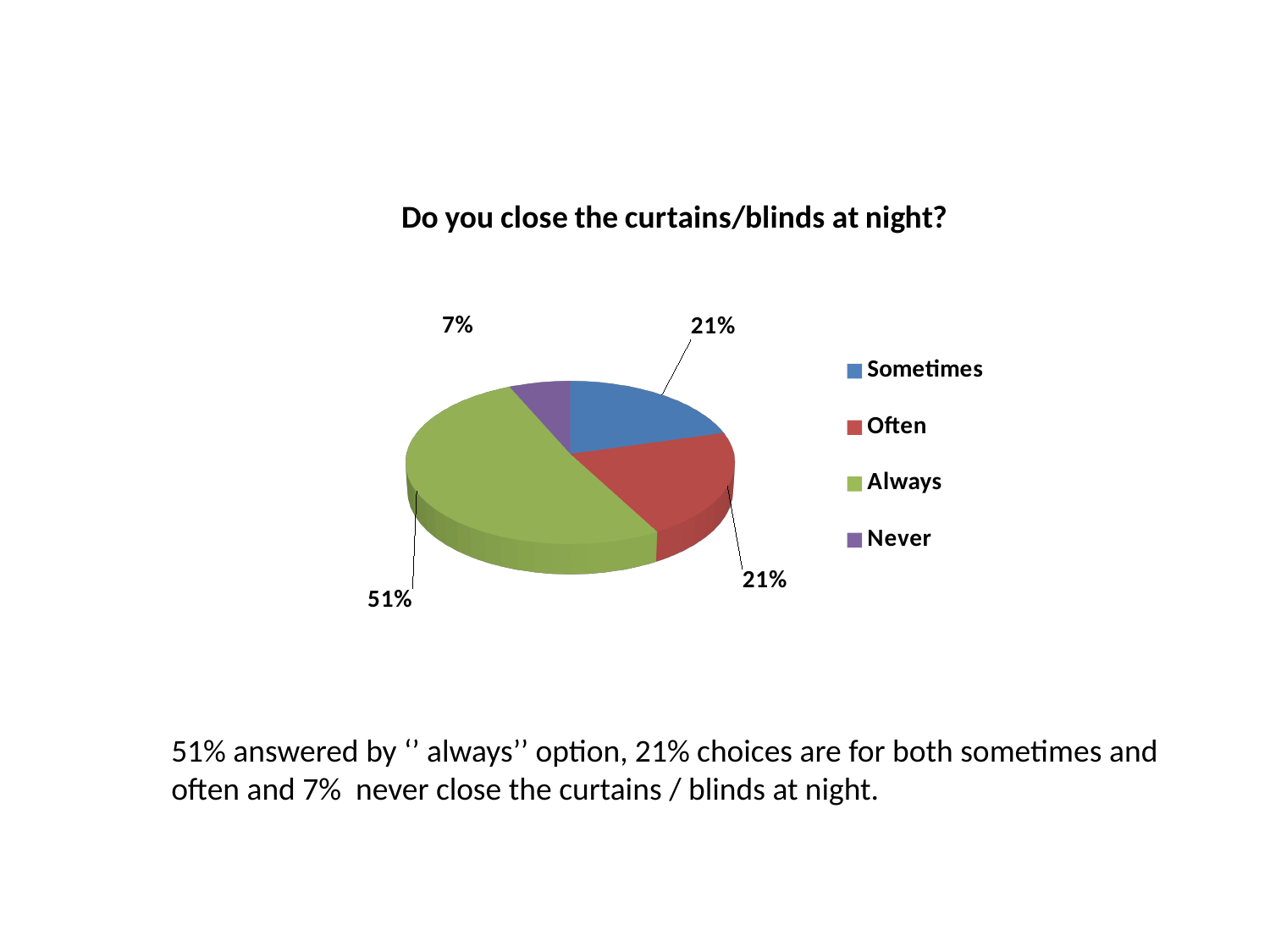
What colour is the Always slice? green What is the difference in percentage points between the Always slice and the Never slice? 44 What share of the pie is labelled for Often? 21% How many categories does the legend list? 4 What is the chart's title? Do you close the curtains/blinds at night? Which category has the largest slice of the pie? Always What kind of chart is shown on the slide? pie chart Which is larger, the Always slice or the Often slice? Always What share of the pie is labelled for Never? 7% Which category has the smallest slice of the pie? Never What share of the pie is labelled for Sometimes? 21%